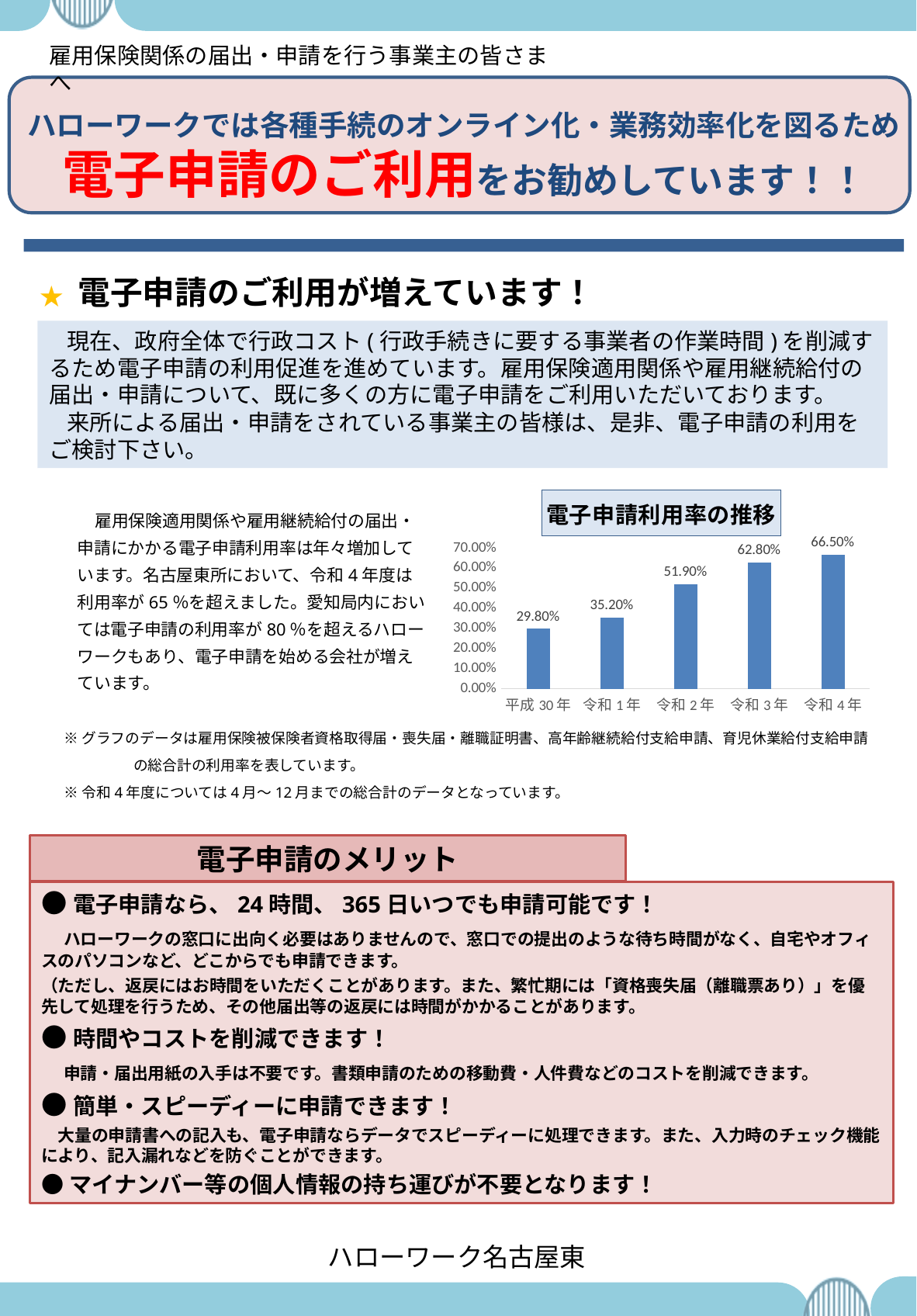
Is the value for 令和3年 in the 電子申請利用率の推移 chart greater or less than 60.00%? greater What kind of chart is the 電子申請利用率の推移 chart? bar chart Which is larger in the 電子申請利用率の推移 chart, the value for 令和1年 or 令和2年? 令和2年 Which year has the highest value in the 電子申請利用率の推移 chart? 令和4年 What is the value for 令和4年 in the 電子申請利用率の推移 chart? 66.50% Which year has the lowest value in the 電子申請利用率の推移 chart? 平成30年 What is the value for 平成30年 in the 電子申請利用率の推移 chart? 29.80% What is the value for 令和2年 in the 電子申請利用率の推移 chart? 51.90% Do the values in the 電子申請利用率の推移 chart rise or fall from 平成30年 to 令和4年? rise What is the difference between the values for 令和3年 and 令和2年 in the 電子申請利用率の推移 chart? 10.90% How many years are shown in the 電子申請利用率の推移 chart? 5 What is the difference between the values for 令和4年 and 平成30年 in the 電子申請利用率の推移 chart? 36.70%